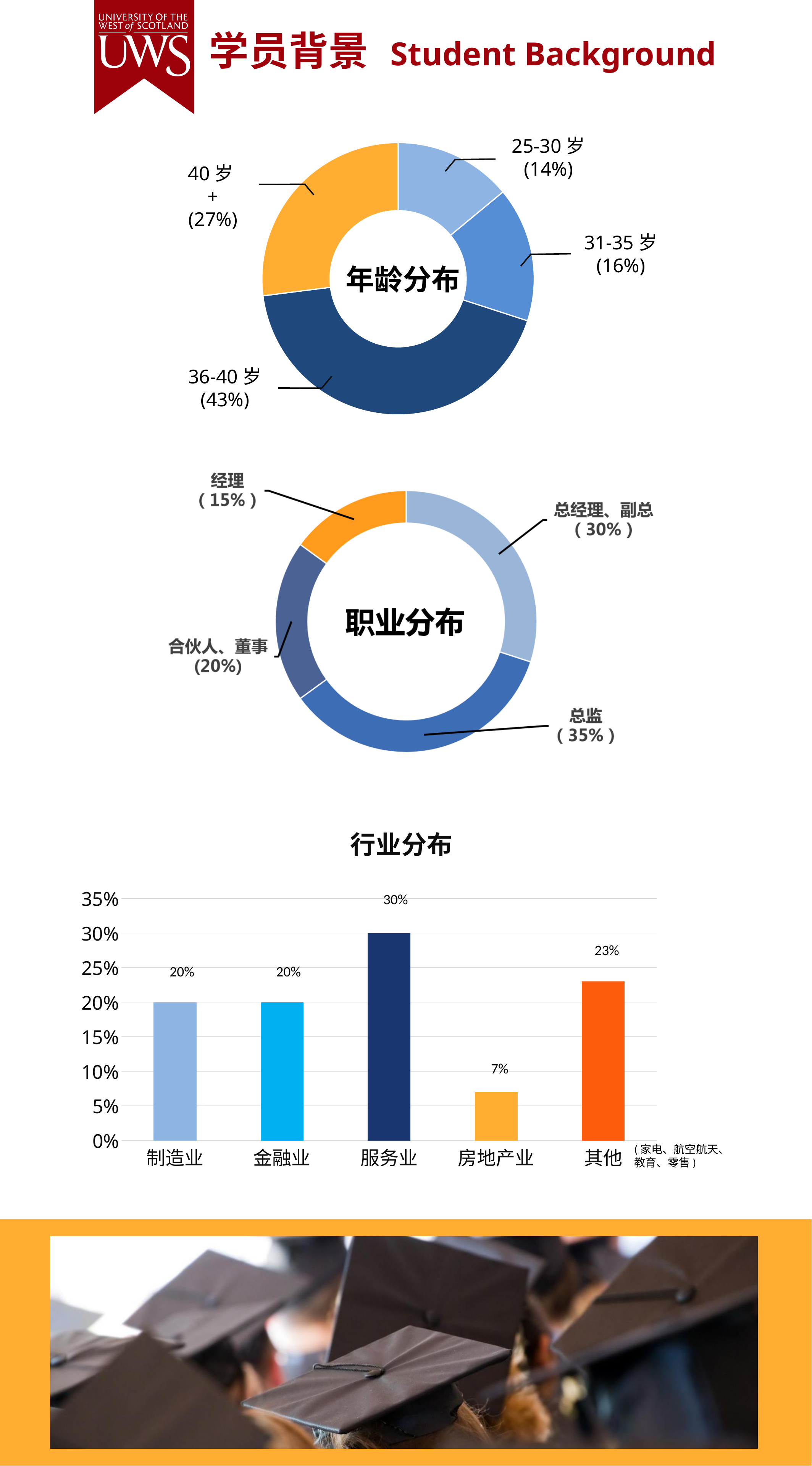
In the 年龄分布 chart, what is the difference between the shares of 40 岁+ and 31-35 岁? 11% In the 年龄分布 chart, how many age groups are shown? 4 What kind of chart is the 职业分布 chart? Donut (pie) chart In the 职业分布 chart, which is larger: the share of 经理 or the share of 合伙人、董事? 合伙人、董事 In the 职业分布 chart, which occupation group has the largest share? 总监 What kind of chart is the 行业分布 chart? Bar chart In the 行业分布 chart, what is the value for 服务业? 30% In the 行业分布 chart, which industry has the lowest value? 房地产业 In the 年龄分布 chart, what share of students are aged 36-40 岁? 43% In the 行业分布 chart, what is the difference between 其他 and 房地产业? 16% In the 职业分布 chart, what share of students are 总监? 35% In the 年龄分布 chart, which age group has the smallest share? 25-30 岁